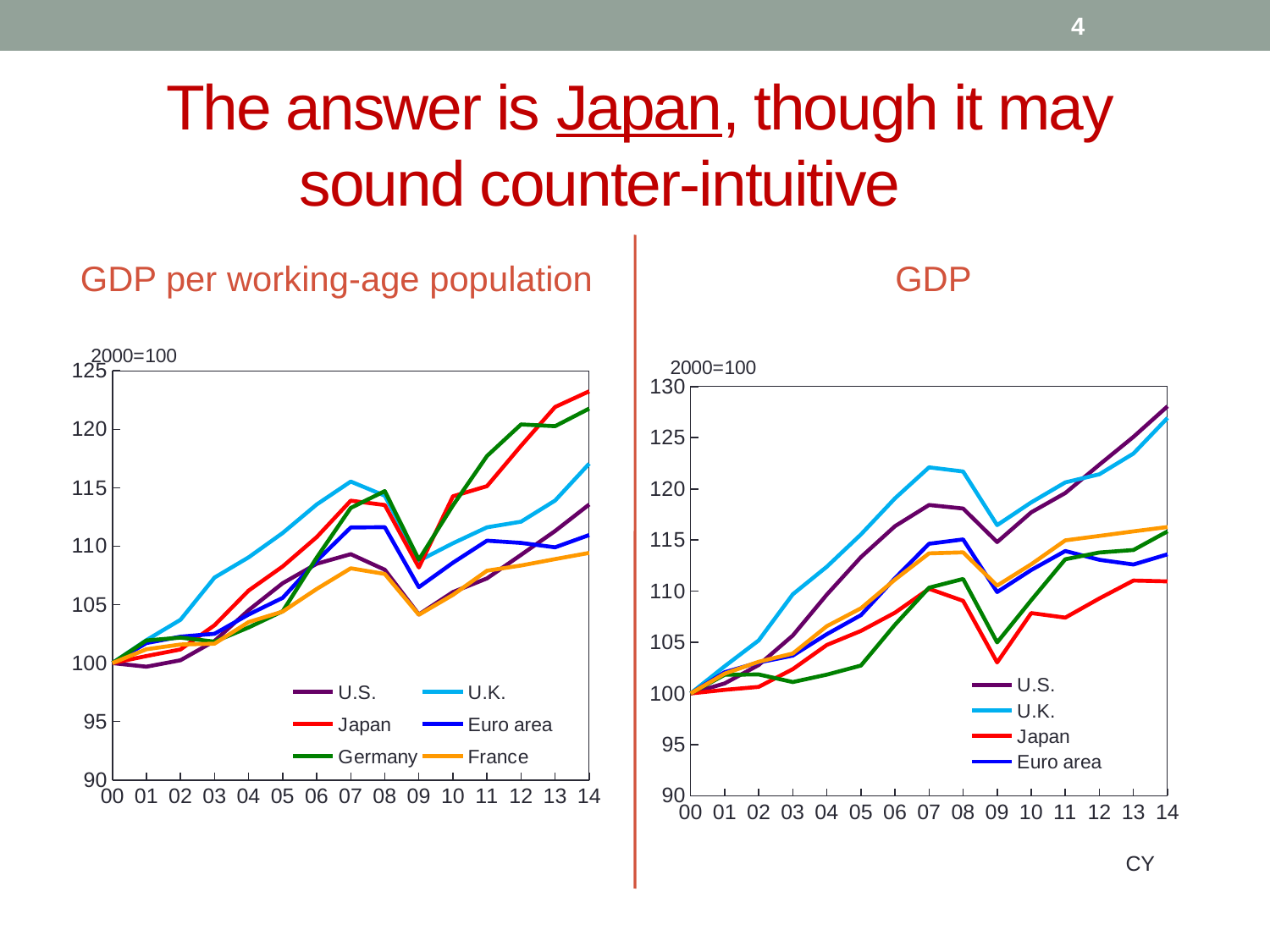
In the 'GDP per working-age population' chart, is the value for France in 14 greater or less than 110? less What base year and value is indicated above the y axis of both charts? 2000=100 How many series does the legend of the 'GDP' chart on the right list? 4 In the 'GDP per working-age population' chart, which series has the lowest value in 14? France In the 'GDP' chart on the right, is the value for Japan in 09 greater or less than 105? less In the 'GDP' chart on the right, which series has the lowest value in 14? Japan In the 'GDP' chart on the right, is the value for U.K. in 07 greater or less than 120? greater In the 'GDP' chart on the right, which series has the highest value in 14? U.S. What kind of chart is the 'GDP per working-age population' chart on the left? line chart How many series does the legend of the 'GDP per working-age population' chart list? 6 In the 'GDP per working-age population' chart, which series has the highest value in 14? Japan